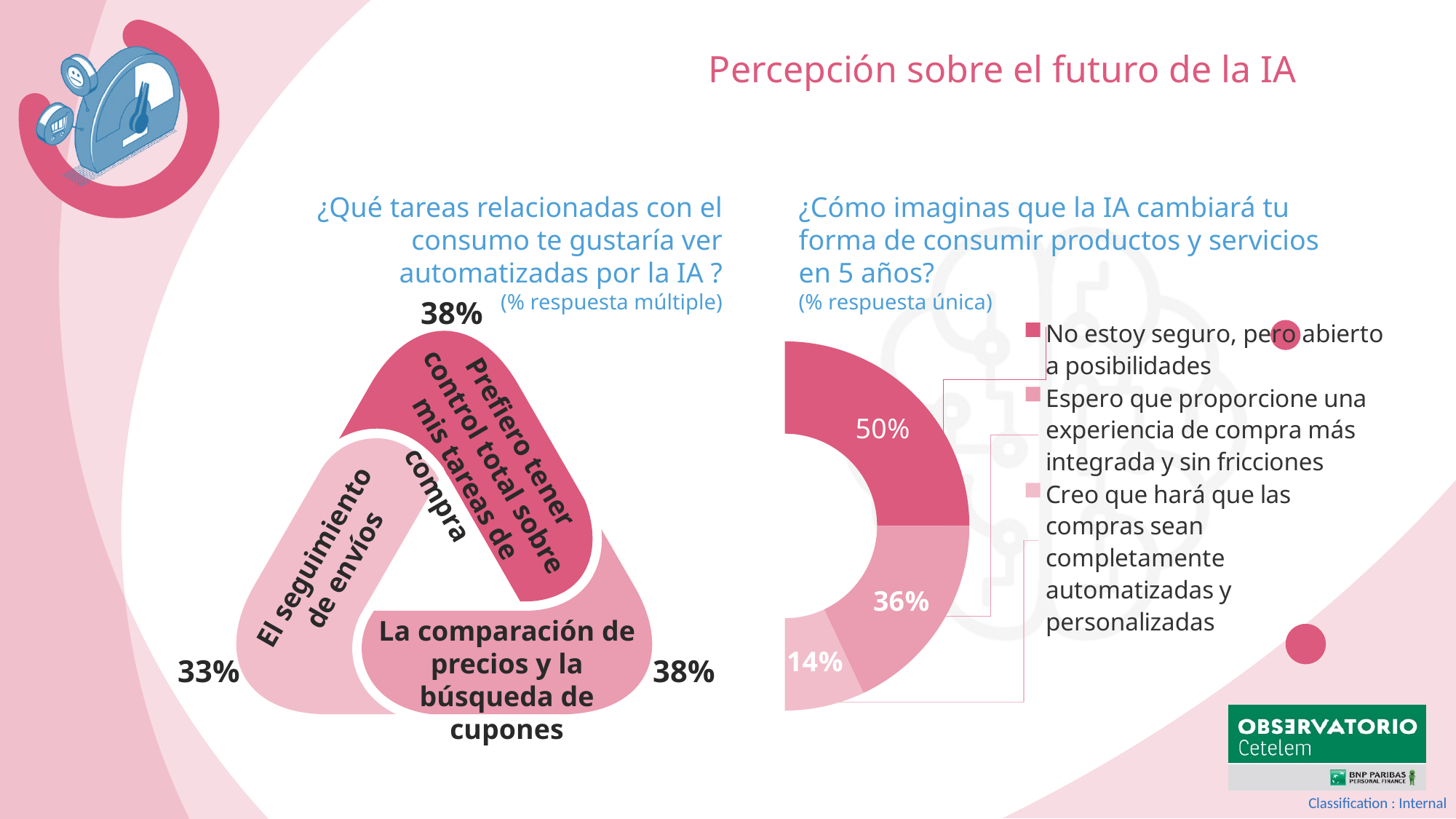
How many entries does the legend of the chart on the right list? 3 In the diagram on the left, what is the difference between the percentage for 'Prefiero tener control total sobre mis tareas de compra' and the percentage for 'El seguimiento de envíos'? 5 percentage points In the chart on the right, which response has the smallest share? Creo que hará que las compras sean completamente automatizadas y personalizadas In the chart on the right, what is the difference between the share for 'No estoy seguro, pero abierto a posibilidades' and the share for 'Espero que proporcione una experiencia de compra más integrada y sin fricciones'? 14 percentage points In the diagram on the left (¿Qué tareas relacionadas con el consumo te gustaría ver automatizadas por la IA?), what percentage is shown for 'El seguimiento de envíos'? 33% In the chart on the right, which response has the largest share? No estoy seguro, pero abierto a posibilidades In the chart on the right (¿Cómo imaginas que la IA cambiará tu forma de consumir productos y servicios en 5 años?), what percentage corresponds to 'No estoy seguro, pero abierto a posibilidades'? 50% What kind of chart is the chart on the right? Donut (pie) chart In the diagram on the left, what percentage is shown for 'La comparación de precios y la búsqueda de cupones'? 38% In the chart on the right, what percentage corresponds to 'Creo que hará que las compras sean completamente automatizadas y personalizadas'? 14% In the diagram on the left, which task has the lowest percentage? El seguimiento de envíos In the chart on the right, what percentage corresponds to 'Espero que proporcione una experiencia de compra más integrada y sin fricciones'? 36%